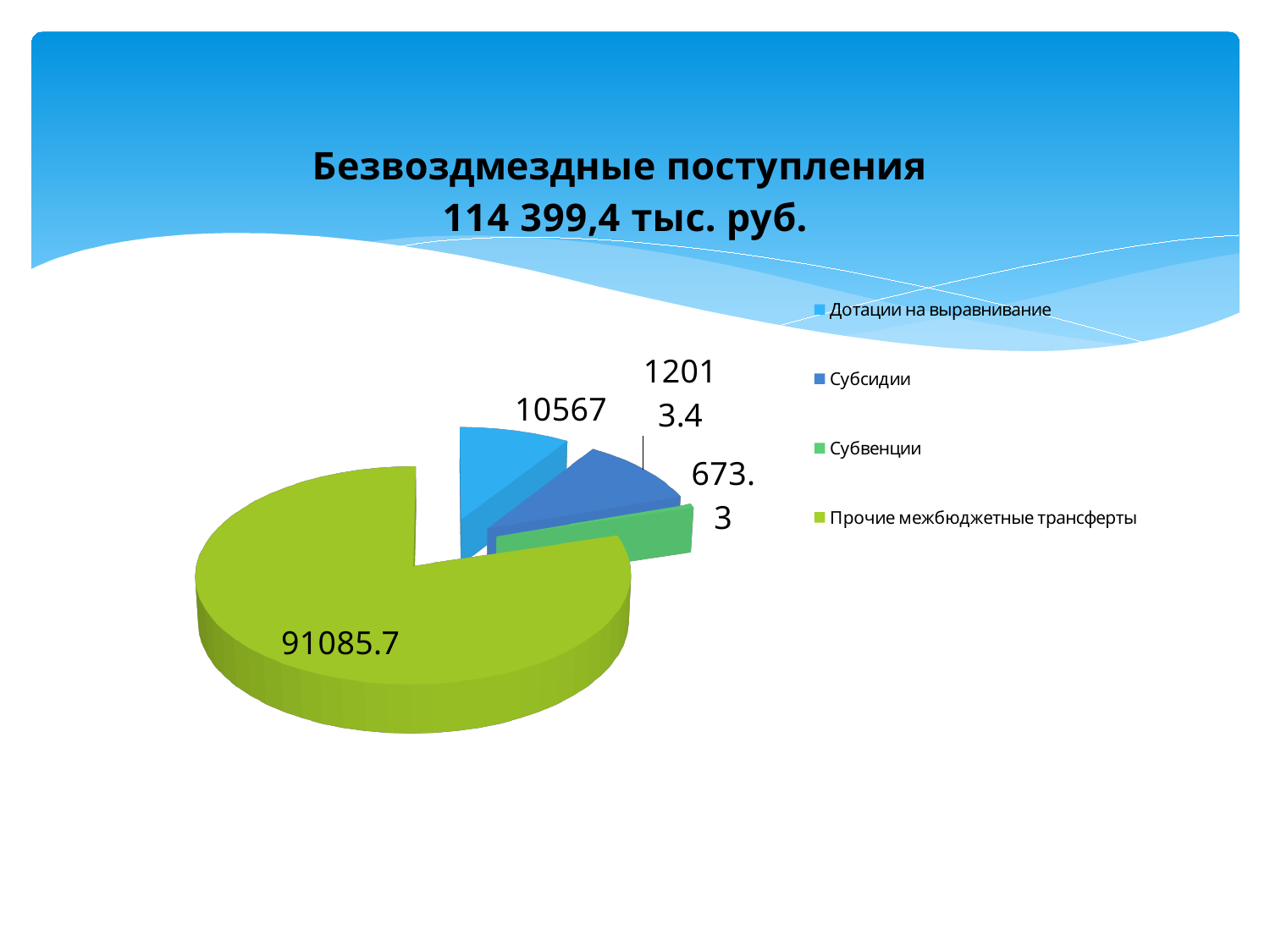
What is the title of the chart? Безвоздмездные поступления 114 399,4 тыс. руб. What is the difference between the values for Прочие межбюджетные трансферты and Дотации на выравнивание? 80518.7 Which is larger, Субсидии or Субвенции? Субсидии What is the value for Прочие межбюджетные трансферты? 91085.7 What is the value for Субвенции? 673.3 Which category has the largest slice of the pie? Прочие межбюджетные трансферты How many entries does the legend list? 4 What kind of chart is shown on the slide? pie chart Which category has the smallest slice of the pie? Субвенции How many slices does the pie chart have? 4 What is the value for Субсидии? 12013.4 What is the value for Дотации на выравнивание? 10567